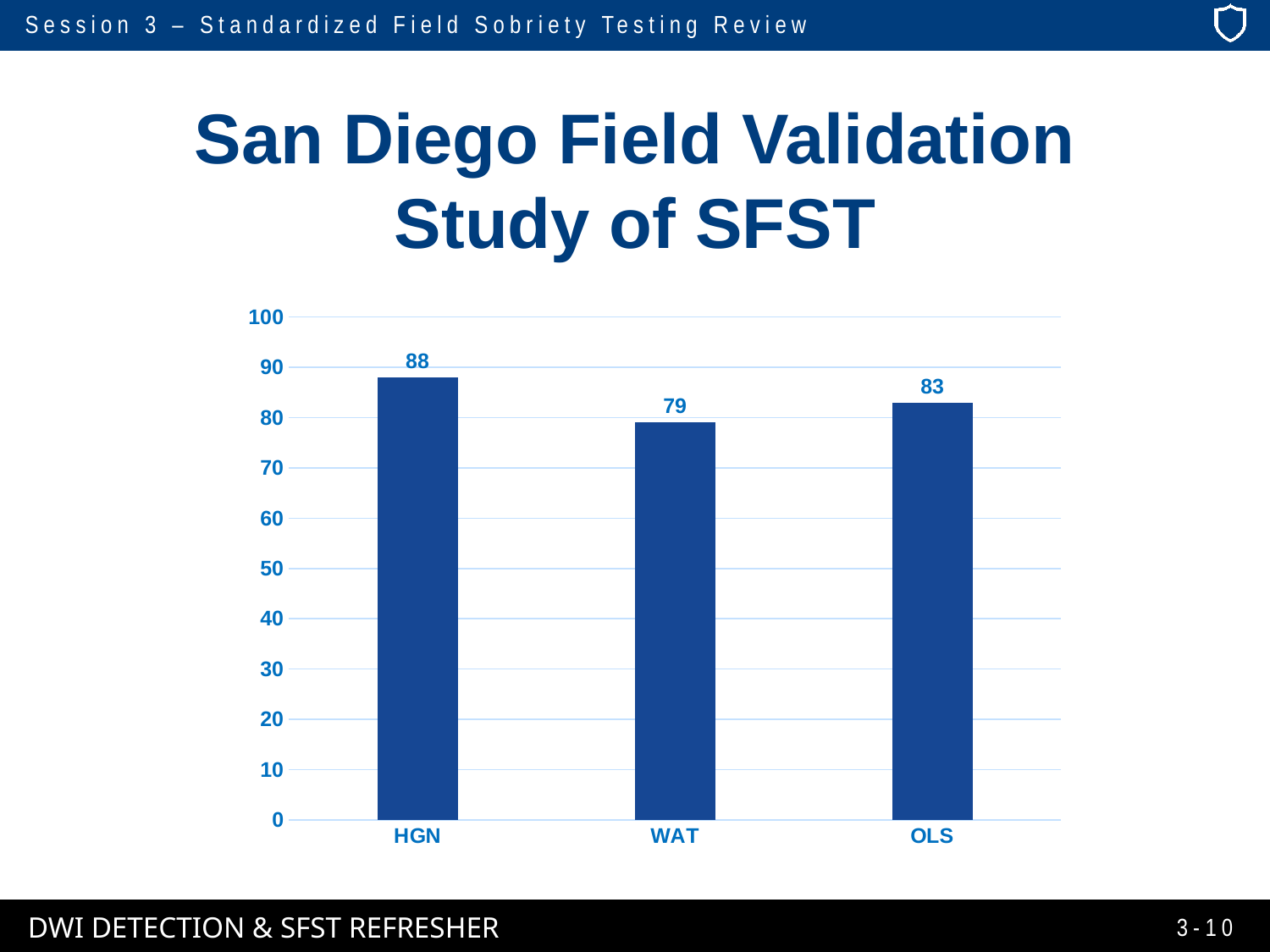
Which is larger, the value for OLS or the value for WAT? OLS Is the value for WAT greater or less than 80? less Which category has the highest value? HGN What is the value for WAT? 79 What is the title of the slide containing the chart? San Diego Field Validation Study of SFST What is the difference between the values for HGN and WAT? 9 What kind of chart is shown on the slide? bar chart What is the value for HGN? 88 Which category has the lowest value? WAT What is the value for OLS? 83 How many categories are shown on the x axis? 3 What is the difference between the values for OLS and WAT? 4